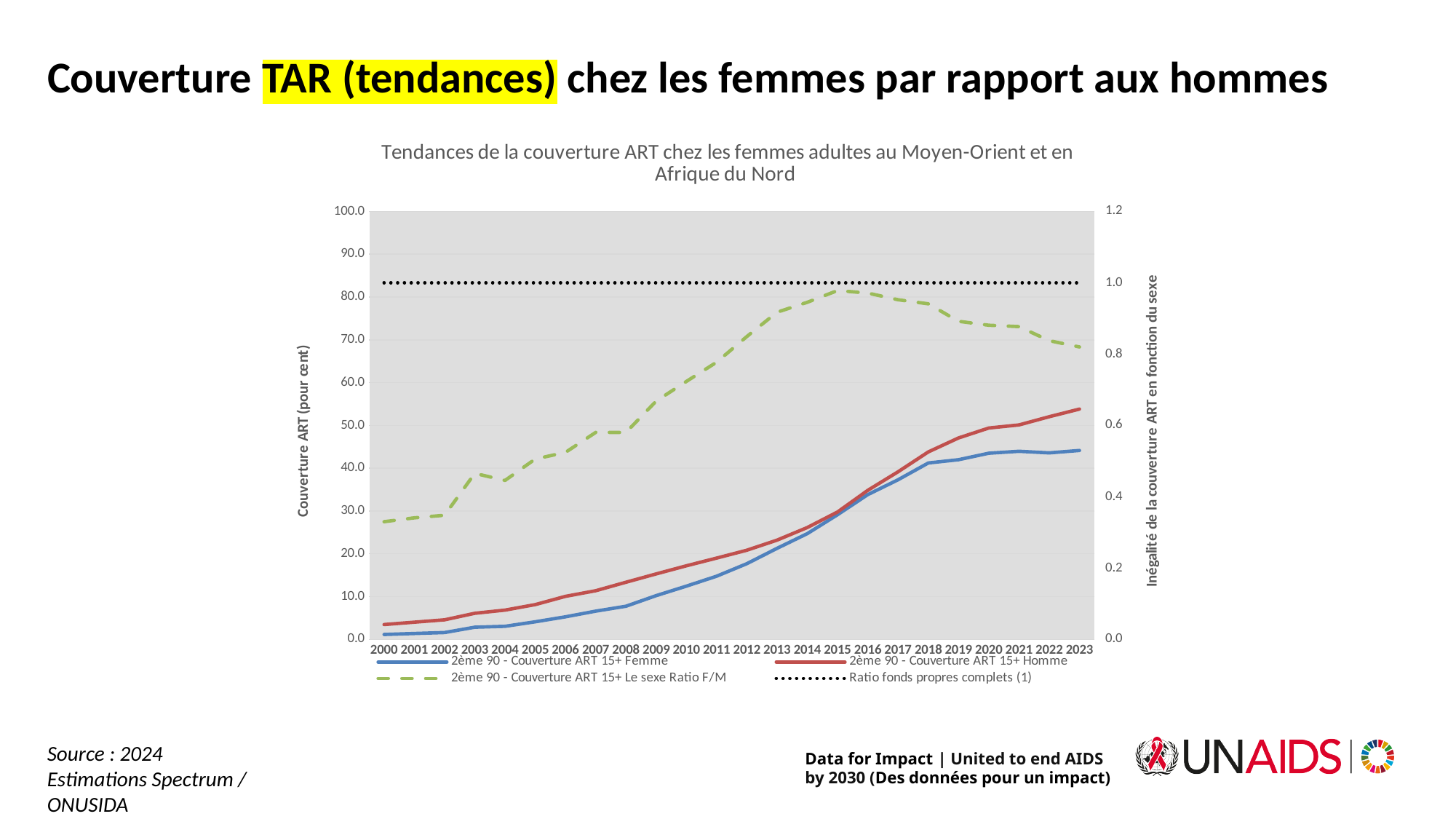
In 2023, which is larger: the ART coverage for Femme or for Homme? Homme How many series does the chart legend list? 4 On the right axis, is the value for '2ème 90 - Couverture ART 15+ Le sexe Ratio F/M' in 2023 greater or less than 0.9? less Does the '2ème 90 - Couverture ART 15+ Le sexe Ratio F/M' line rise or fall from 2016 to 2023? fall Is the value for '2ème 90 - Couverture ART 15+ Femme' in 2023 greater or less than 40? greater Does the '2ème 90 - Couverture ART 15+ Femme' line rise or fall from 2000 to 2023? rise What kind of chart is shown on the slide? line chart Is the value for '2ème 90 - Couverture ART 15+ Homme' in 2000 greater or less than 10? less How many years are plotted along the x axis of the chart? 24 What is the title of the chart? Tendances de la couverture ART chez les femmes adultes au Moyen-Orient et en Afrique du Nord In which year is the '2ème 90 - Couverture ART 15+ Femme' value lowest? 2000